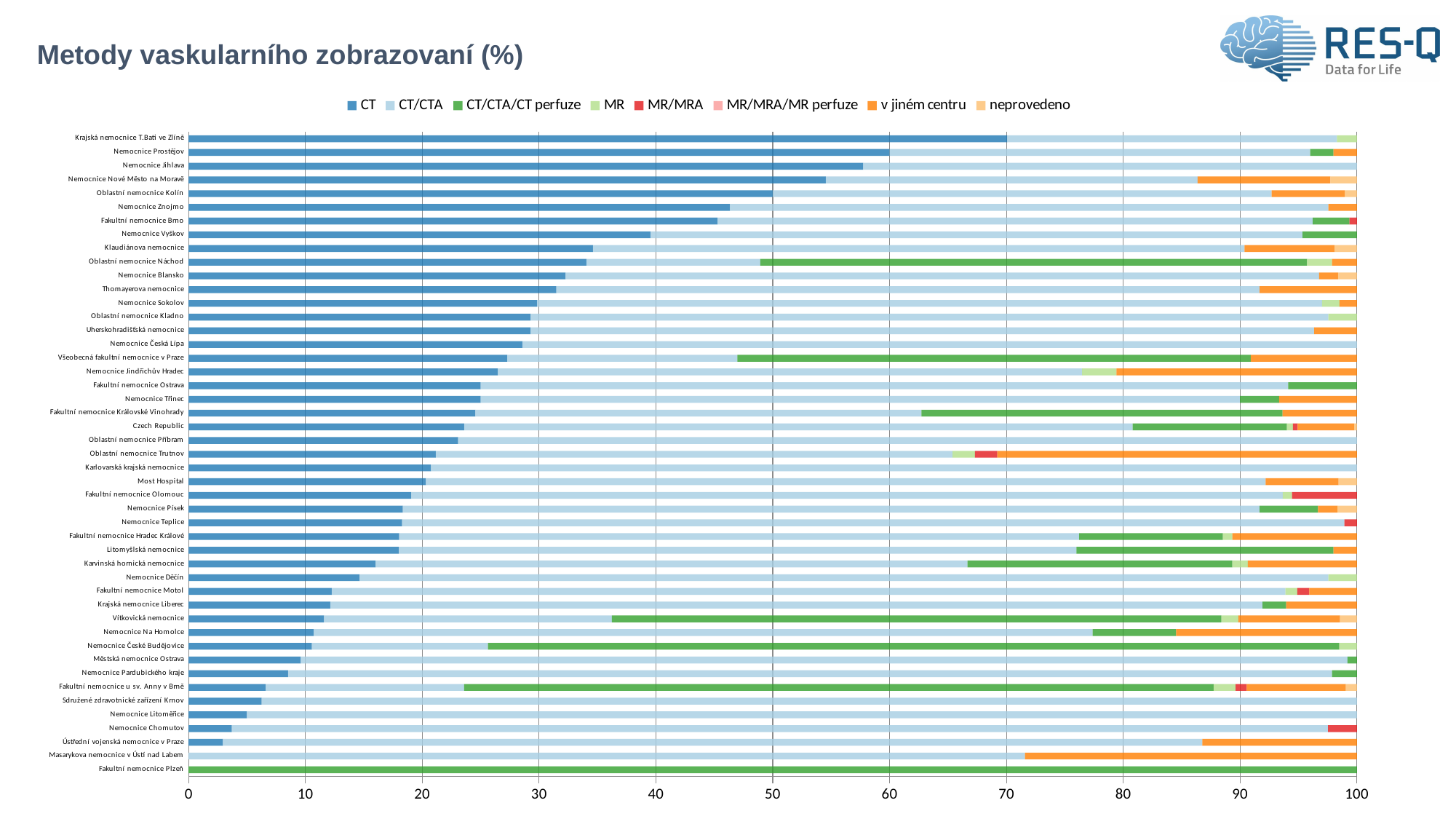
What kind of chart is shown on the slide? Stacked bar chart Which has a larger CT value, Nemocnice Znojmo or Nemocnice Vyškov? Nemocnice Znojmo What is the total of the stacked bar for Fakultní nemocnice Plzeň? 100 What is the title of the chart? Metody vaskularního zobrazovaní (%) Which hospital's bar consists entirely of CT/CTA/CT perfuze? Fakultní nemocnice Plzeň Do the CT values rise or fall going from the top of the chart to the bottom? fall Is the CT value for Nemocnice Jihlava greater or less than 50? greater Which hospital has the highest CT share? Krajská nemocnice T.Bati ve Zlíně Is the CT value for Nemocnice Chomutov greater or less than 10? less What is the CT value for Nemocnice Prostějov? 60 How many series does the legend list? 8 What is the CT value for Oblastní nemocnice Kolín? 50